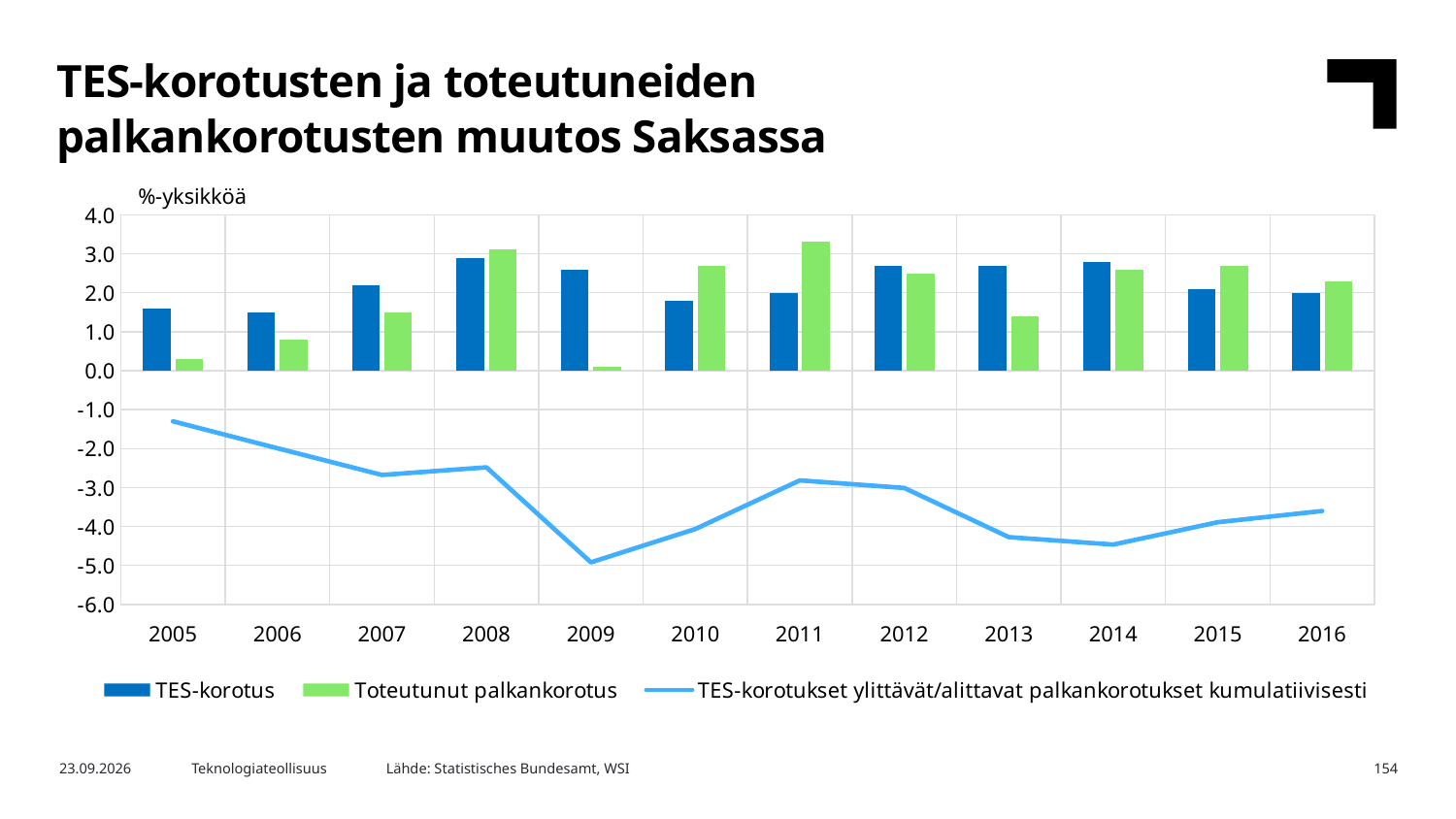
In 2009, which is larger: TES-korotus or Toteutunut palkankorotus? TES-korotus How many series does the legend list? 3 Does the cumulative line rise or fall from 2014 to 2016? rises How many years are shown on the x axis? 12 In which year does the line 'TES-korotukset ylittävät/alittavat palkankorotukset kumulatiivisesti' reach its lowest point? 2009 In 2011, which is larger: TES-korotus or Toteutunut palkankorotus? Toteutunut palkankorotus Is the Toteutunut palkankorotus value for 2005 greater or less than 1.0? less Is the TES-korotus value for 2008 greater or less than 2.0? greater In which year is the Toteutunut palkankorotus bar highest? 2011 In which year is the Toteutunut palkankorotus bar lowest? 2009 What kind of chart is shown on the slide? A combined bar and line chart What unit label is shown above the y axis? %-yksikköä